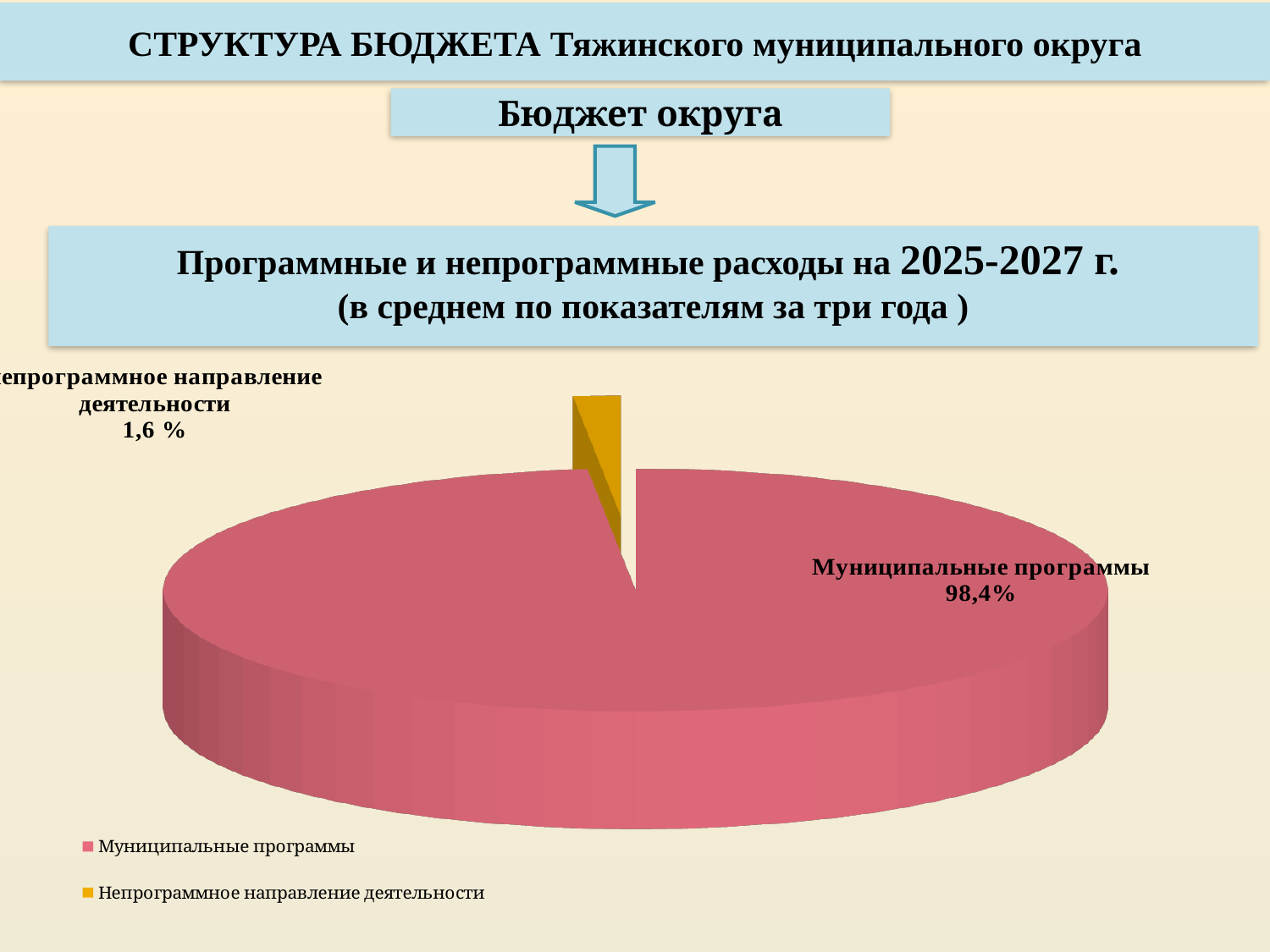
What kind of chart is shown on the slide? Pie chart Which slice of the pie is the largest? Муниципальные программы Which is larger: the share of "Муниципальные программы" or the share of "Непрограммное направление деятельности"? Муниципальные программы How many slices does the pie chart have? 2 What colour is the "Непрограммное направление деятельности" slice? Yellow (gold) How many entries does the legend list? 2 What share of the pie does "Муниципальные программы" have? 98,4% What period does the chart heading say the expenditures refer to? 2025-2027 г. Which slice of the pie is the smallest? Непрограммное направление деятельности What share of the pie does "Непрограммное направление деятельности" have? 1,6 % What is the difference in percentage points between "Муниципальные программы" and "Непрограммное направление деятельности"? 96,8